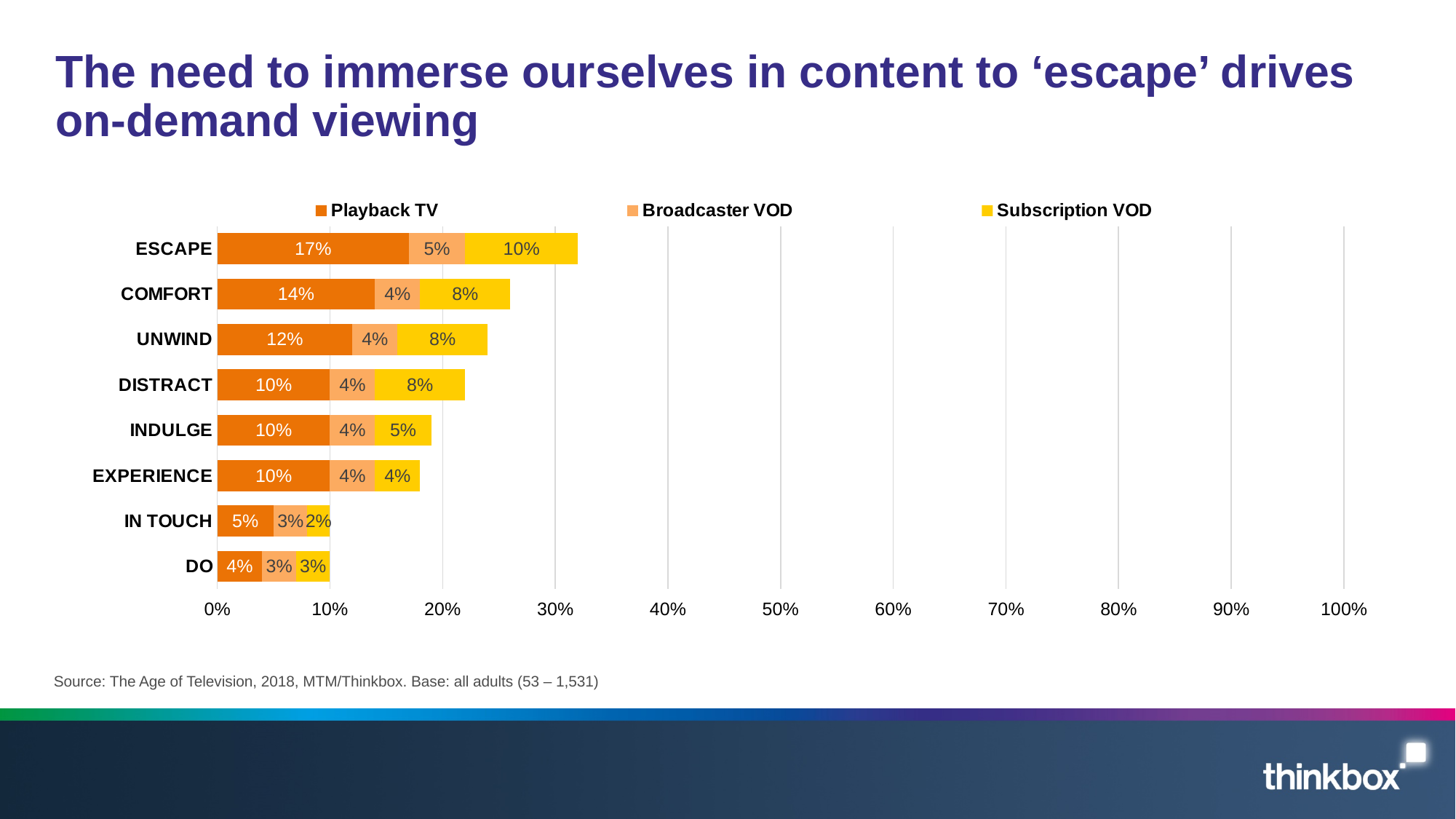
How many series does the legend list? 3 What is the difference between the Playback TV values for ESCAPE and COMFORT? 3% What is the total of the stacked bar for ESCAPE? 32% Which category has the lowest Subscription VOD value? IN TOUCH What is the total of the stacked bar for DO? 10% What is the Playback TV value for ESCAPE? 17% Which is larger: the Subscription VOD value for INDULGE or for EXPERIENCE? INDULGE Which category has the highest Playback TV value? ESCAPE How many categories are shown on the chart? 8 What kind of chart is shown on the slide? Stacked bar chart What is the Subscription VOD value for COMFORT? 8% What is the Broadcaster VOD value for IN TOUCH? 3%